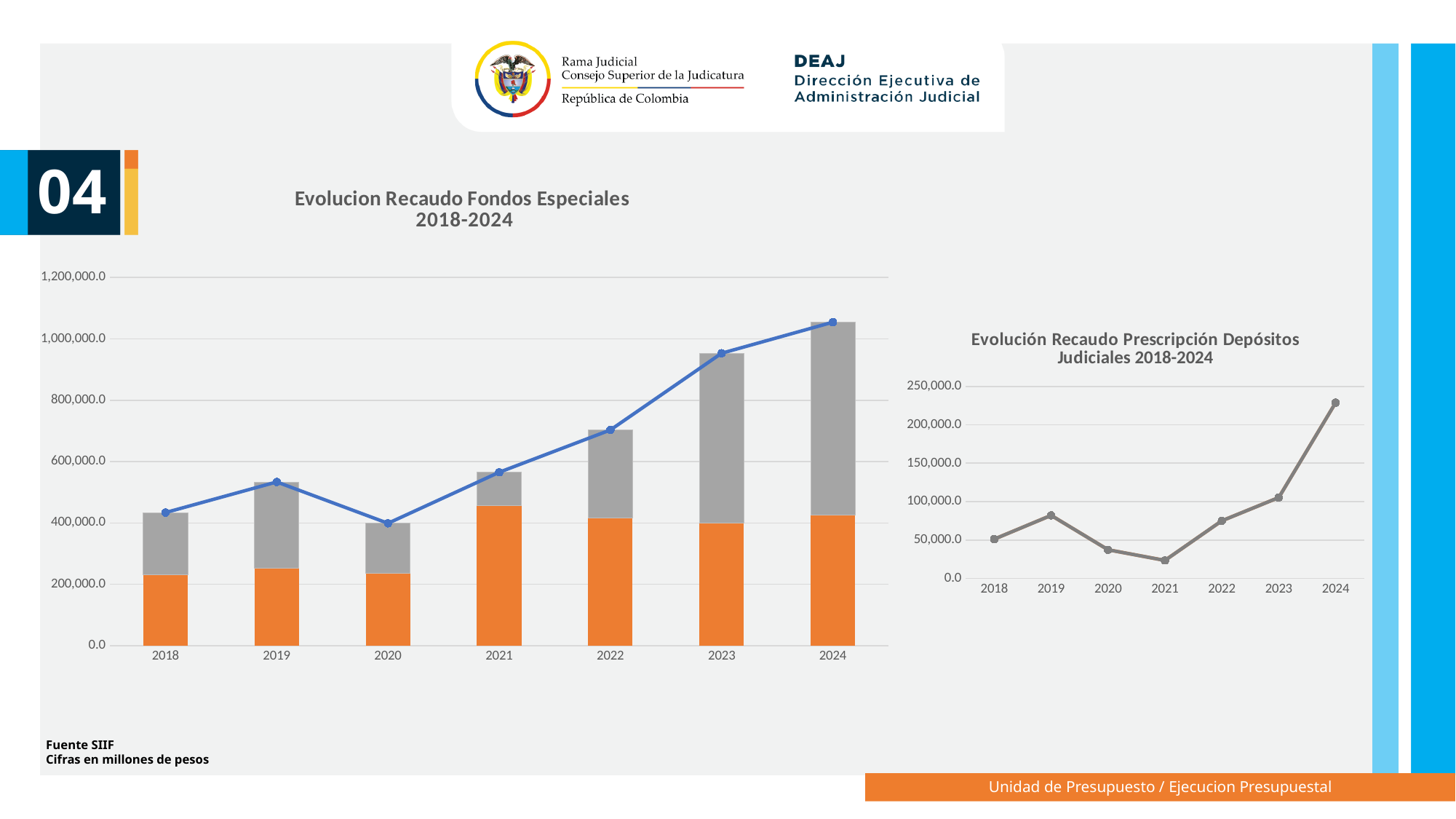
In the 'Evolución Recaudo Prescripción Depósitos Judiciales 2018-2024' chart, which year has the lowest value? 2021 In the 'Evolucion Recaudo Fondos Especiales 2018-2024' chart, which year has the tallest bar? 2024 In the 'Evolución Recaudo Prescripción Depósitos Judiciales 2018-2024' chart, which year has the highest value? 2024 What kind of chart is the 'Evolucion Recaudo Fondos Especiales 2018-2024' chart on the left? Stacked bar chart with a line In the 'Evolución Recaudo Prescripción Depósitos Judiciales 2018-2024' chart, which is larger, the value for 2019 or the value for 2020? 2019 In the 'Evolucion Recaudo Fondos Especiales 2018-2024' chart, is the total value for 2020 greater or less than 600,000.0? less In the 'Evolucion Recaudo Fondos Especiales 2018-2024' chart, how many years are shown on the x axis? 7 In the 'Evolucion Recaudo Fondos Especiales 2018-2024' chart, is the total value for 2024 greater or less than 1,000,000.0? greater In the 'Evolución Recaudo Prescripción Depósitos Judiciales 2018-2024' chart, how many data points are plotted? 7 In the 'Evolucion Recaudo Fondos Especiales 2018-2024' chart, which year has the shortest bar? 2020 What kind of chart is the 'Evolución Recaudo Prescripción Depósitos Judiciales 2018-2024' chart on the right? Line chart In the 'Evolución Recaudo Prescripción Depósitos Judiciales 2018-2024' chart, is the value for 2024 greater or less than 200,000.0? greater